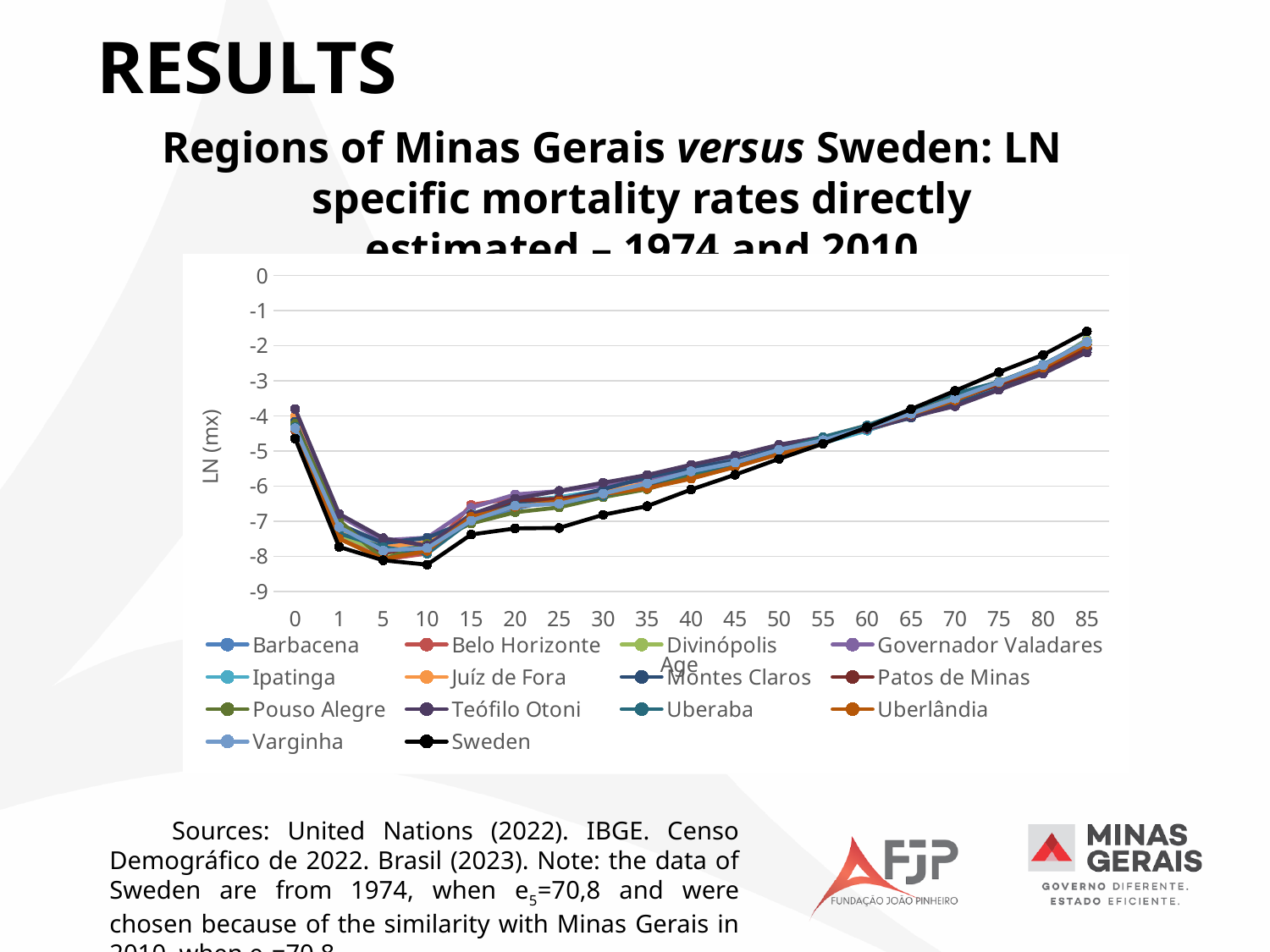
Do the values for Sweden rise or fall from age 10 to age 85? rise What kind of chart is shown on the slide? Line chart What is the label of the vertical axis? LN (mx) Which series has the highest value at age 85? Sweden How many age categories are shown along the x axis? 19 Is the value for Sweden at age 85 greater or less than -2? greater Is the value for Sweden at age 25 greater or less than -7? less Is the value for Sweden at age 0 greater or less than -4? less Which series is drawn in black? Sweden How many series does the legend list? 14 Which series has the lowest value at age 10? Sweden